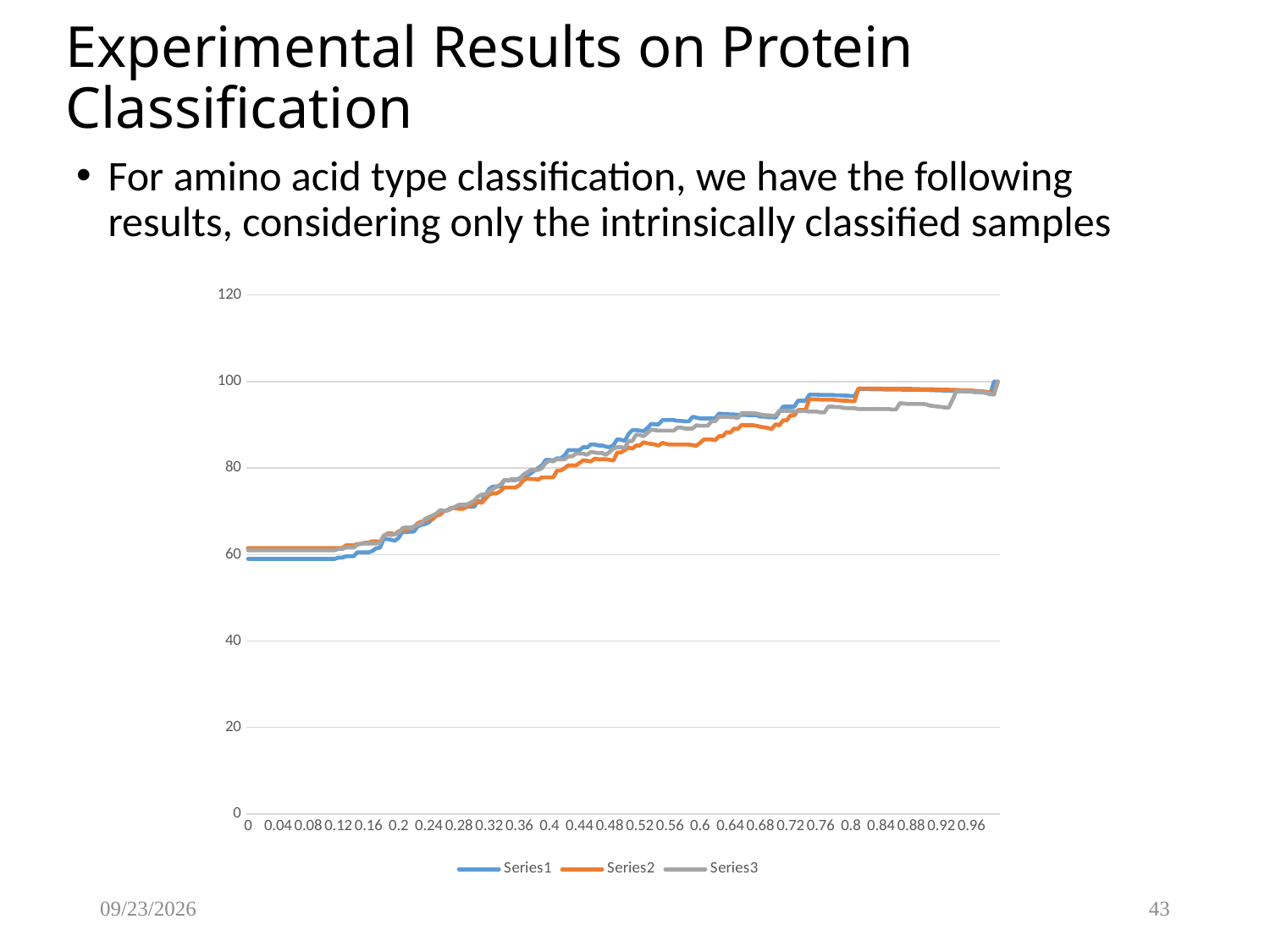
Is the value of Series2 at x = 0 greater or less than 60? greater What colour is the line for Series2 in the legend? orange Is the value of Series2 at x = 0.2 greater or less than 60? greater Is the value of Series3 at x = 0.8 greater or less than 100? less At x = 0, which is higher, Series1 or Series2? Series2 What is the highest value shown on the y axis? 120 How many series does the legend list? 3 Do the values of Series1 generally rise or fall as the x axis increases from 0 to 0.96? rise What kind of chart is shown on the slide? line chart At x = 0.6, which is higher, Series1 or Series2? Series1